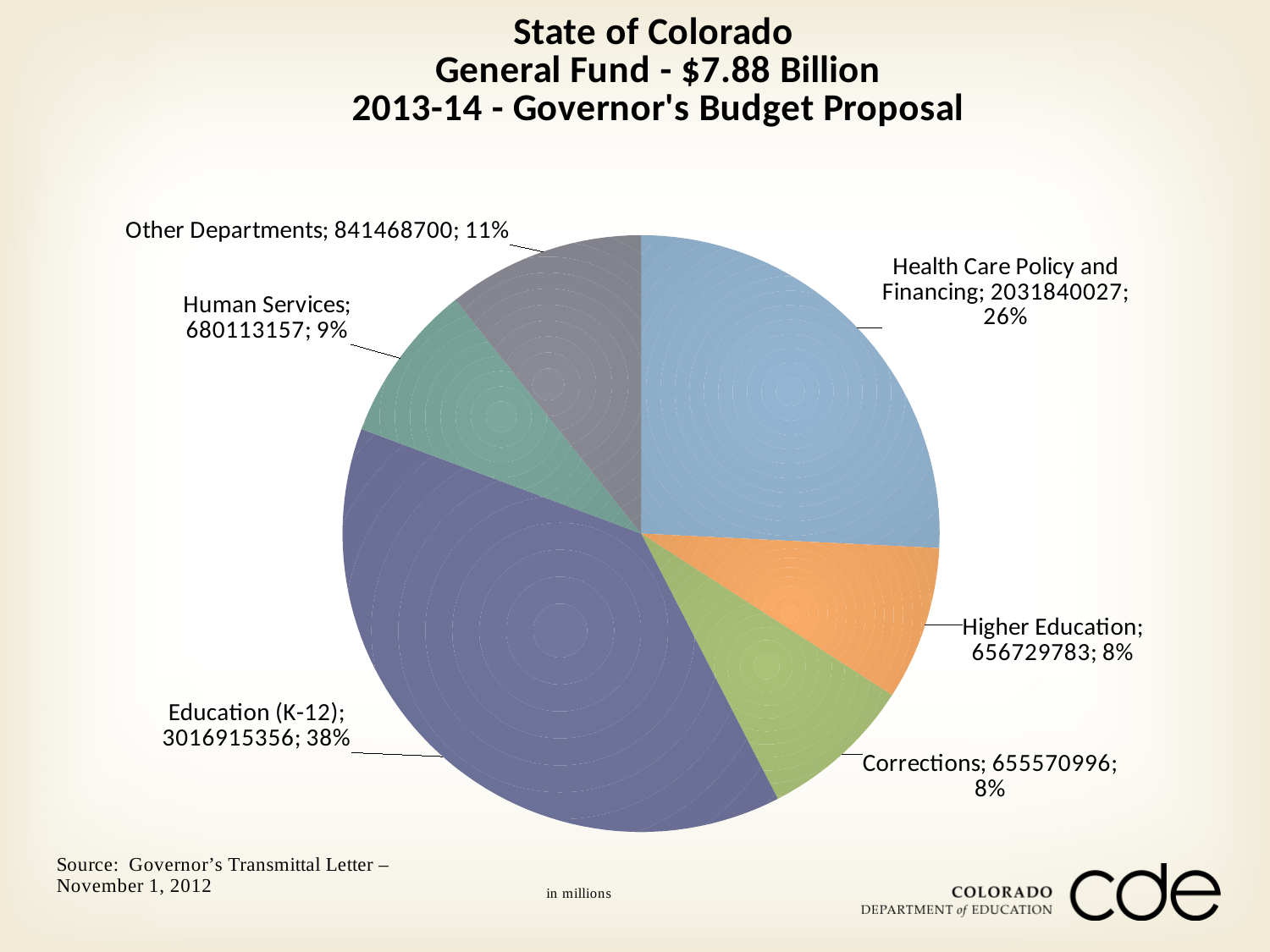
What is the difference between the values for Other Departments and Human Services? 161355543 What is the value shown for Education (K-12)? 3016915356 Which is larger, the value for Other Departments or the value for Human Services? Other Departments What total General Fund amount is stated in the chart title? $7.88 Billion What percentage of the General Fund goes to Health Care Policy and Financing? 26% What type of chart is shown on the slide? pie chart How many slices does the pie chart have? 6 What share of the pie does Other Departments represent? 11% What is the difference between the values for Education (K-12) and Health Care Policy and Financing? 985075329 What is the value shown for Human Services? 680113157 Which category has the largest share of the pie? Education (K-12) Which category has the smallest value in the pie chart? Corrections